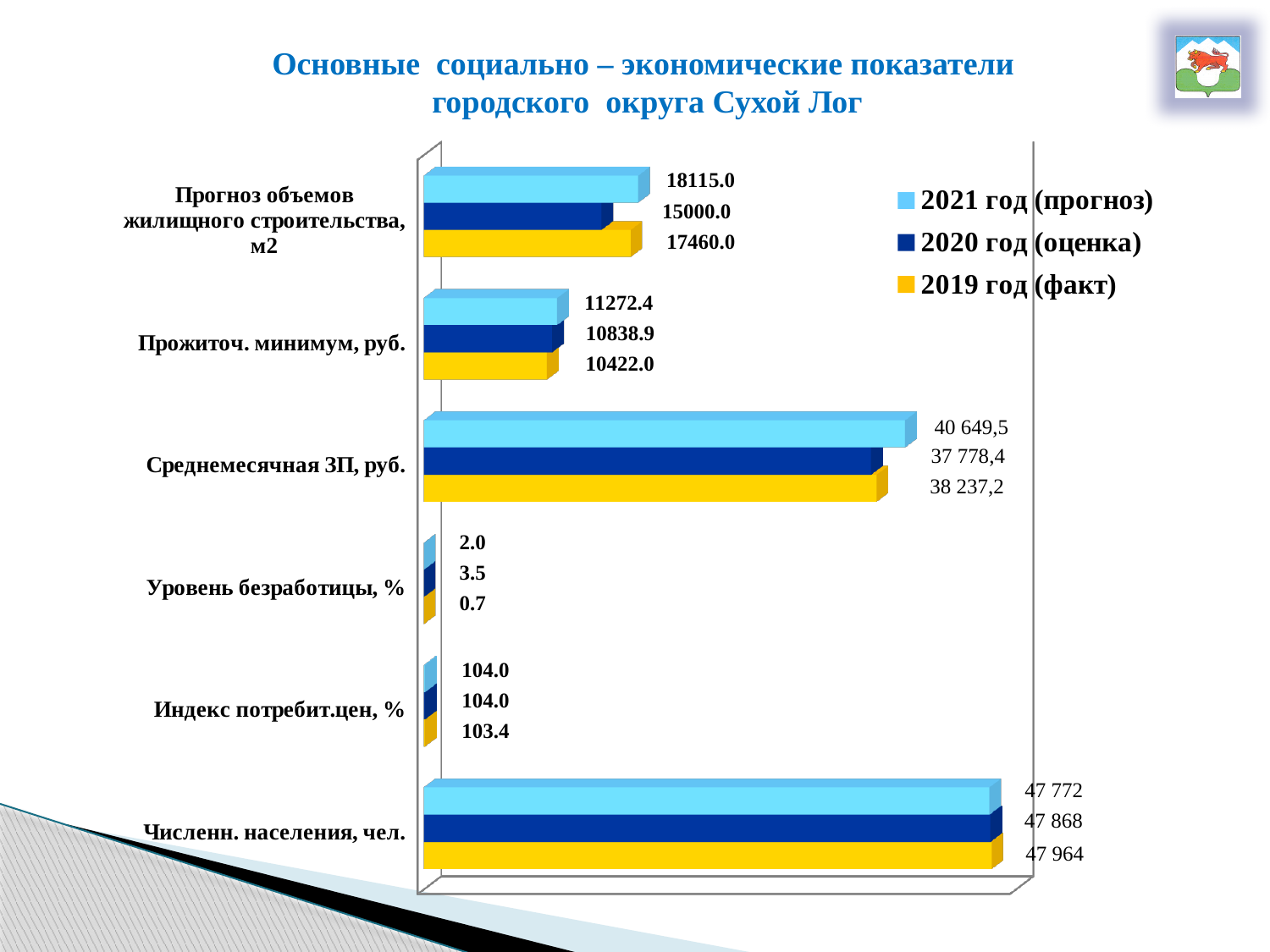
What is the value for 2019 год (факт) in the category Прожиточ. минимум, руб.? 10422.0 What is the value for 2021 год (прогноз) in the category Прогноз объемов жилищного строительства, м2? 18115.0 What is the value for 2019 год (факт) in the category Численн. населения, чел.? 47 964 Which series has the highest value in the category Уровень безработицы, %? 2020 год (оценка) What is the value for 2020 год (оценка) in the category Среднемесячная ЗП, руб.? 37 778,4 In the category Численн. населения, чел., which is larger: the value for 2019 год (факт) or the value for 2021 год (прогноз)? 2019 год (факт) What is the value for 2020 год (оценка) in the category Уровень безработицы, %? 3.5 What is the difference between the 2021 год (прогноз) and 2020 год (оценка) values in the category Прогноз объемов жилищного строительства, м2? 3115.0 How many series does the legend list? 3 How many categories are shown on the chart? 6 What kind of chart is shown on the slide? Bar chart Which series has the lowest value in the category Прогноз объемов жилищного строительства, м2? 2020 год (оценка)